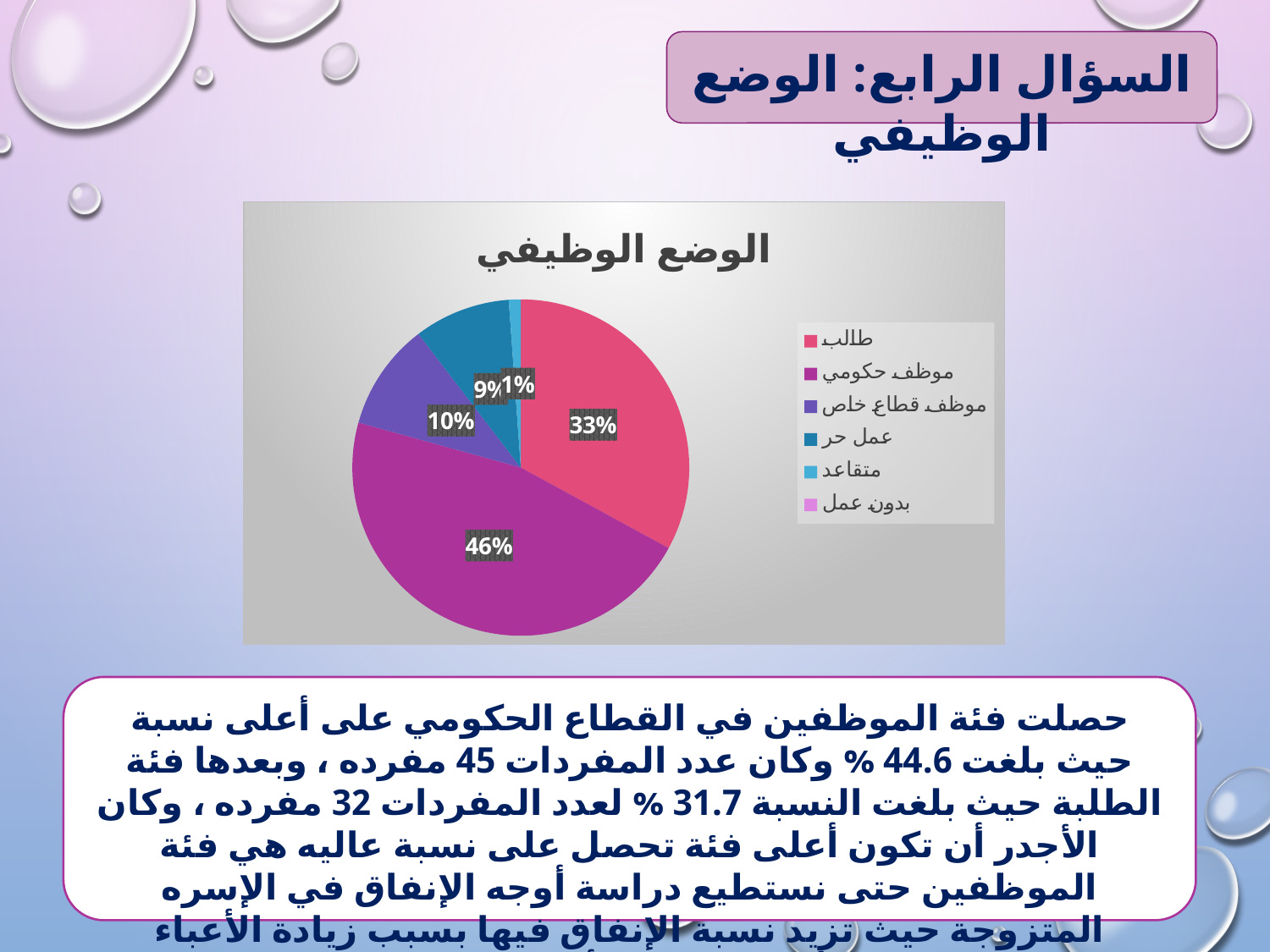
What percentage does the pie chart show for عمل حر (freelance work)? 9% Which slice is larger, طالب or موظف قطاع خاص? طالب What is the difference in percentage points between موظف حكومي and طالب? 13 percentage points What is the title of the chart? الوضع الوظيفي What is the difference in percentage points between موظف قطاع خاص and عمل حر? 1 percentage point Which category has the largest slice in the pie chart? موظف حكومي What percentage does the pie chart show for موظف قطاع خاص (private sector employee)? 10% What percentage does the pie chart show for طالب (student)? 33% What type of chart is shown on the slide? Pie chart How many categories does the legend of the pie chart list? 6 What percentage does the pie chart show for موظف حكومي (government employee)? 46% What is the combined share of طالب and موظف حكومي? 79%